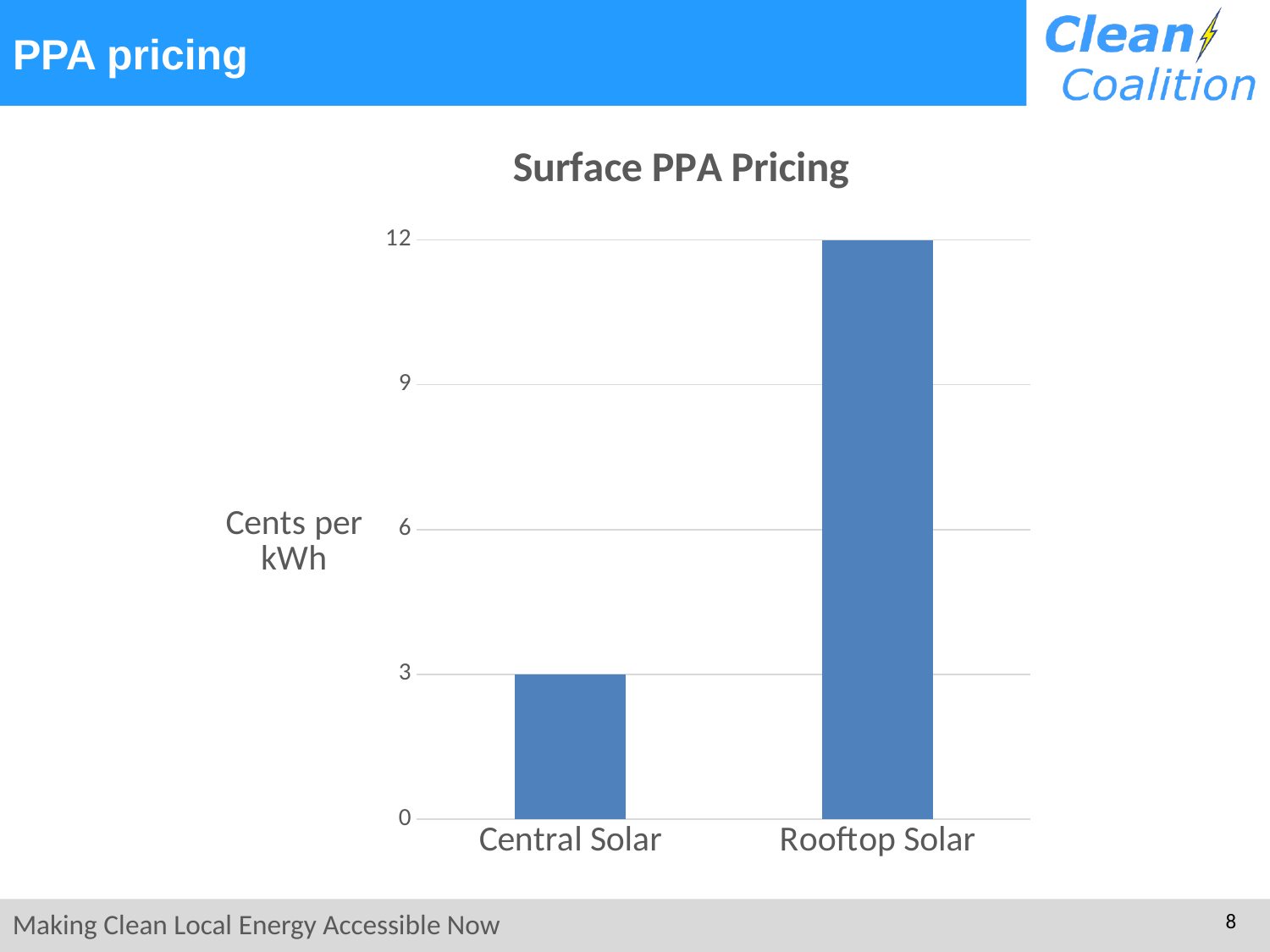
What is the difference between the values for Rooftop Solar and Central Solar? 9 What is the value for Central Solar? 3 What is the value for Rooftop Solar? 12 Is the value for Central Solar greater or less than 6? less What is the title of the chart? Surface PPA Pricing Which category has the lowest value? Central Solar Which category has the highest value? Rooftop Solar What kind of chart is shown on the slide? bar chart Which is larger, the value for Central Solar or the value for Rooftop Solar? Rooftop Solar Is the value for Rooftop Solar greater or less than 9? greater How many categories are shown on the x axis? 2 What is the label on the vertical axis of the chart? Cents per kWh